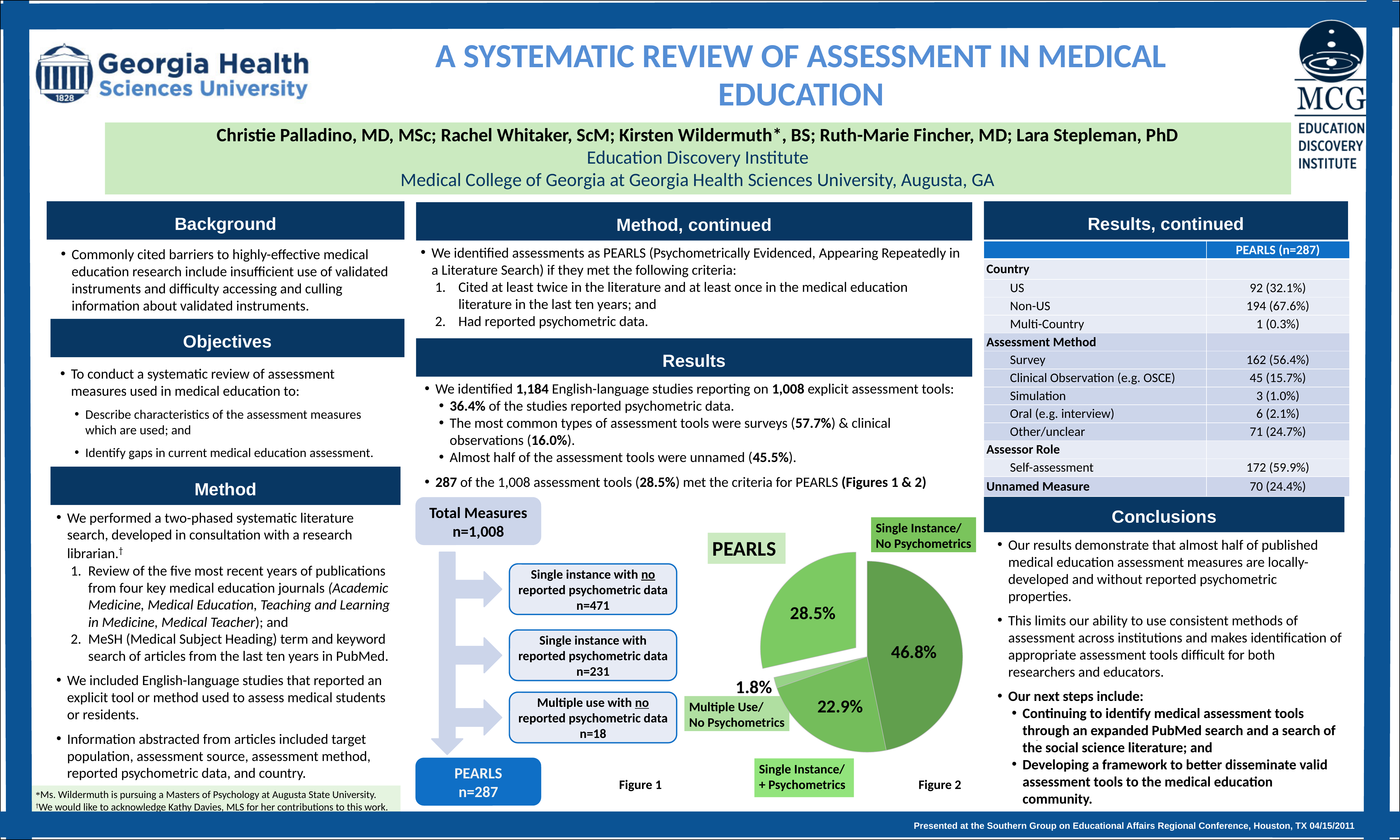
In the Figure 2 pie chart, what percentage is shown for the Single Instance/No Psychometrics slice? 46.8% In the Figure 2 pie chart, what is the difference in percentage points between the Single Instance/No Psychometrics slice and the PEARLS slice? 18.3 percentage points What figure number is given to the pie chart on the slide? Figure 2 In the Figure 2 pie chart, what percentage is shown for the PEARLS slice? 28.5% In the Figure 2 pie chart, how many slices are shown? 4 What kind of chart is Figure 2 on the slide? pie chart In the Figure 2 pie chart, which slice is the largest? Single Instance/No Psychometrics In the Figure 2 pie chart, what percentage is shown for the Single Instance/+ Psychometrics slice? 22.9% In the Figure 2 pie chart, which slice is larger: PEARLS or Single Instance/+ Psychometrics? PEARLS In the Figure 2 pie chart, which slice is the smallest? Multiple Use/No Psychometrics In the Figure 2 pie chart, what is the difference in percentage points between the PEARLS slice and the Single Instance/+ Psychometrics slice? 5.6 percentage points In the Figure 2 pie chart, what percentage is shown for the Multiple Use/No Psychometrics slice? 1.8%